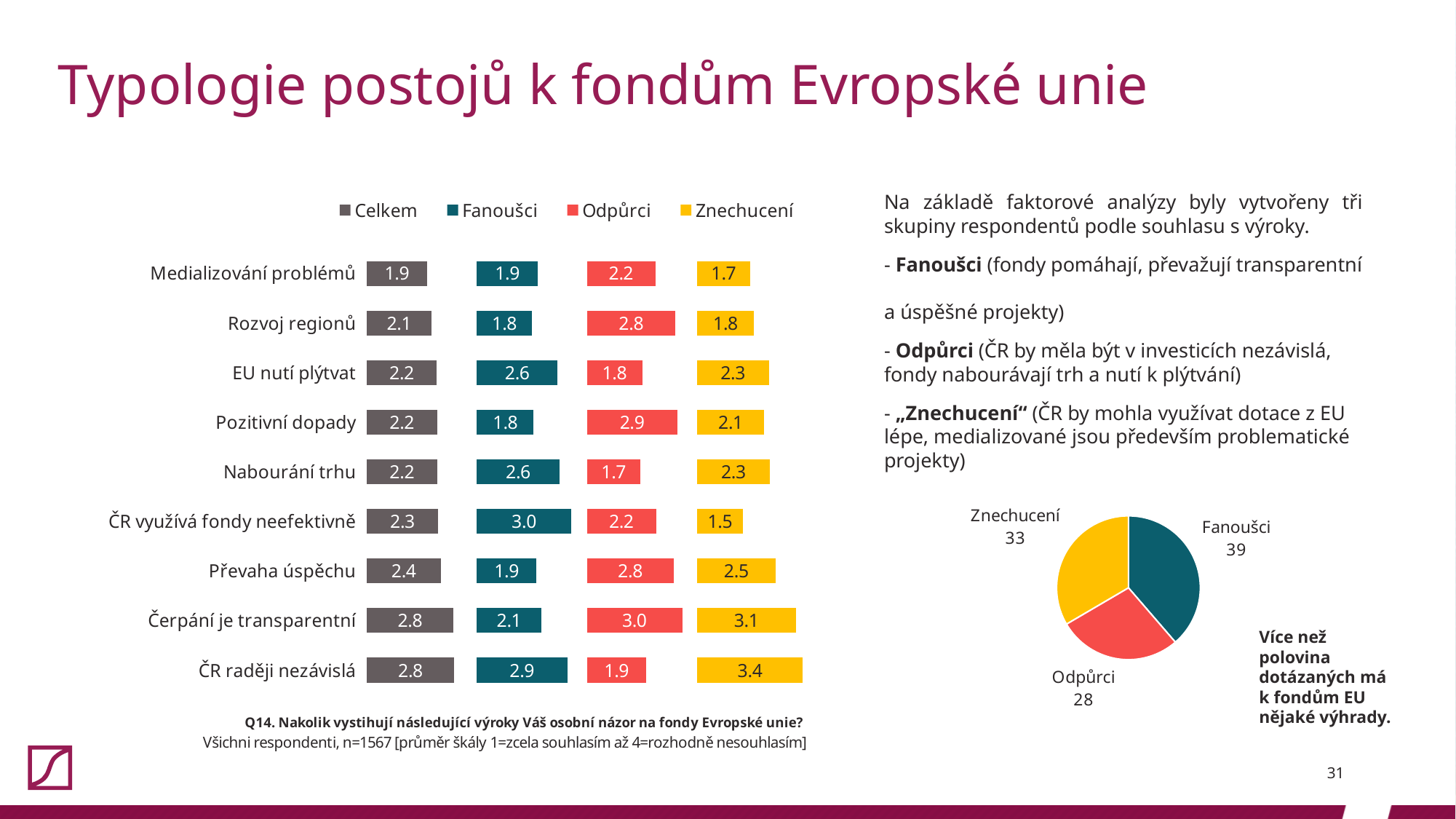
In the bar chart on the left, which category has the lowest Znechucení value? ČR využívá fondy neefektivně In the pie chart on the right, what is the value for Odpůrci? 28 In the bar chart on the left, which is larger for "EU nutí plýtvat": the Fanoušci value or the Odpůrci value? Fanoušci In the bar chart on the left, what is the difference between the Odpůrci and Fanoušci values for "Rozvoj regionů"? 1.0 In the bar chart on the left, what is the Fanoušci value for "ČR využívá fondy neefektivně"? 3.0 In the bar chart on the left, what is the Znechucení value for "Čerpání je transparentní"? 3.1 How many categories are shown in the bar chart on the left? 9 In the bar chart on the left, what is the Celkem value for "ČR raději nezávislá"? 2.8 In the pie chart on the right, which group has the largest slice? Fanoušci In the bar chart on the left, which category has the highest Znechucení value? ČR raději nezávislá How many series does the legend of the bar chart on the left list? 4 In the bar chart on the left, what is the Odpůrci value for "Pozitivní dopady"? 2.9